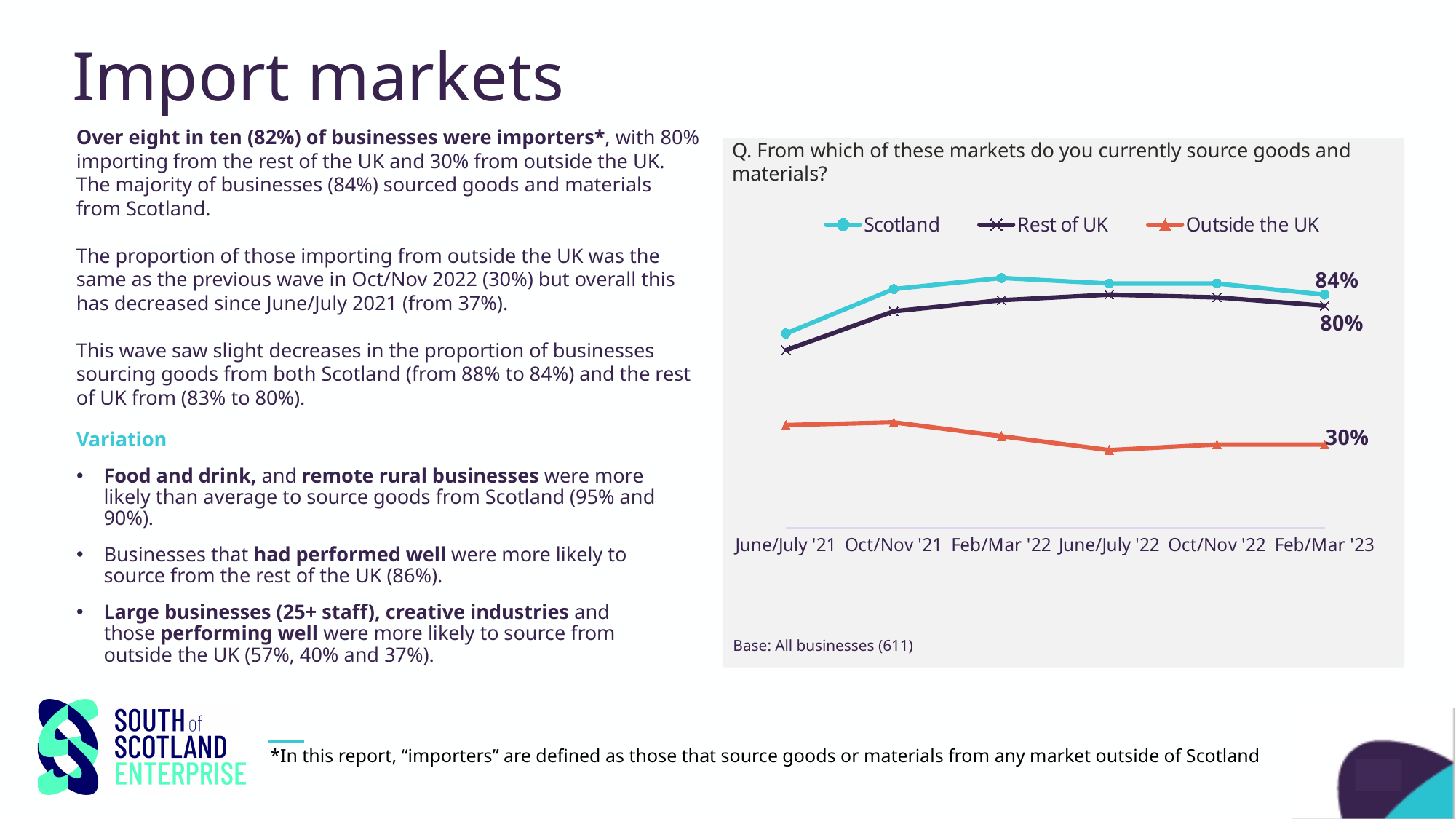
Which series has the lowest value at Feb/Mar '23? Outside the UK What is the value for Scotland at Feb/Mar '23? 84% What is the value for Outside the UK at Feb/Mar '23? 30% What is the value for Rest of UK at Feb/Mar '23? 80% At Feb/Mar '23, which is larger: the value for Rest of UK or the value for Outside the UK? Rest of UK How many time points are shown along the x axis of the chart? 6 What is the difference between the Scotland and Rest of UK values at Feb/Mar '23? 4 percentage points Which series is plotted with triangle markers? Outside the UK What kind of chart is shown on the slide? Line chart Which series has the highest value at Feb/Mar '23? Scotland Does the Outside the UK line rise or fall between Oct/Nov '21 and June/July '22? Fall How many series does the chart legend list? 3